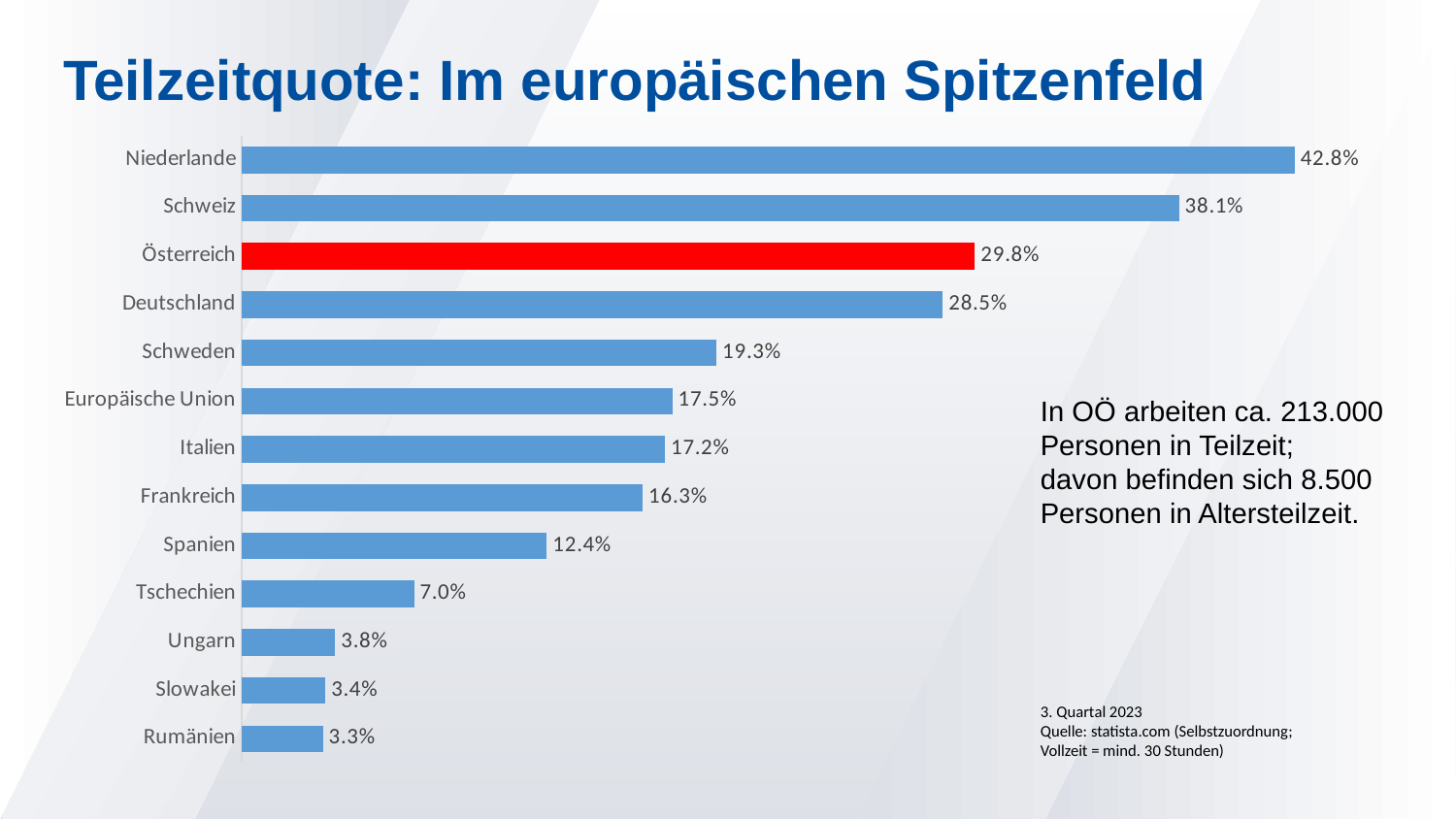
How many countries or regions are shown on the chart? 13 What is the difference between the values for Österreich and Deutschland? 1.3% What is the difference between the values for Niederlande and Schweiz? 4.7% What value is shown for Deutschland? 28.5% What is the part-time rate shown for Österreich? 29.8% Which country has the highest part-time rate on the chart? Niederlande Which has a higher value, Schweden or Spanien? Schweden What value is shown for Europäische Union? 17.5% What kind of chart is shown on the slide? Bar chart Which has a higher value, Italien or Frankreich? Italien Which country has the lowest part-time rate on the chart? Rumänien Which bar is highlighted in red? Österreich